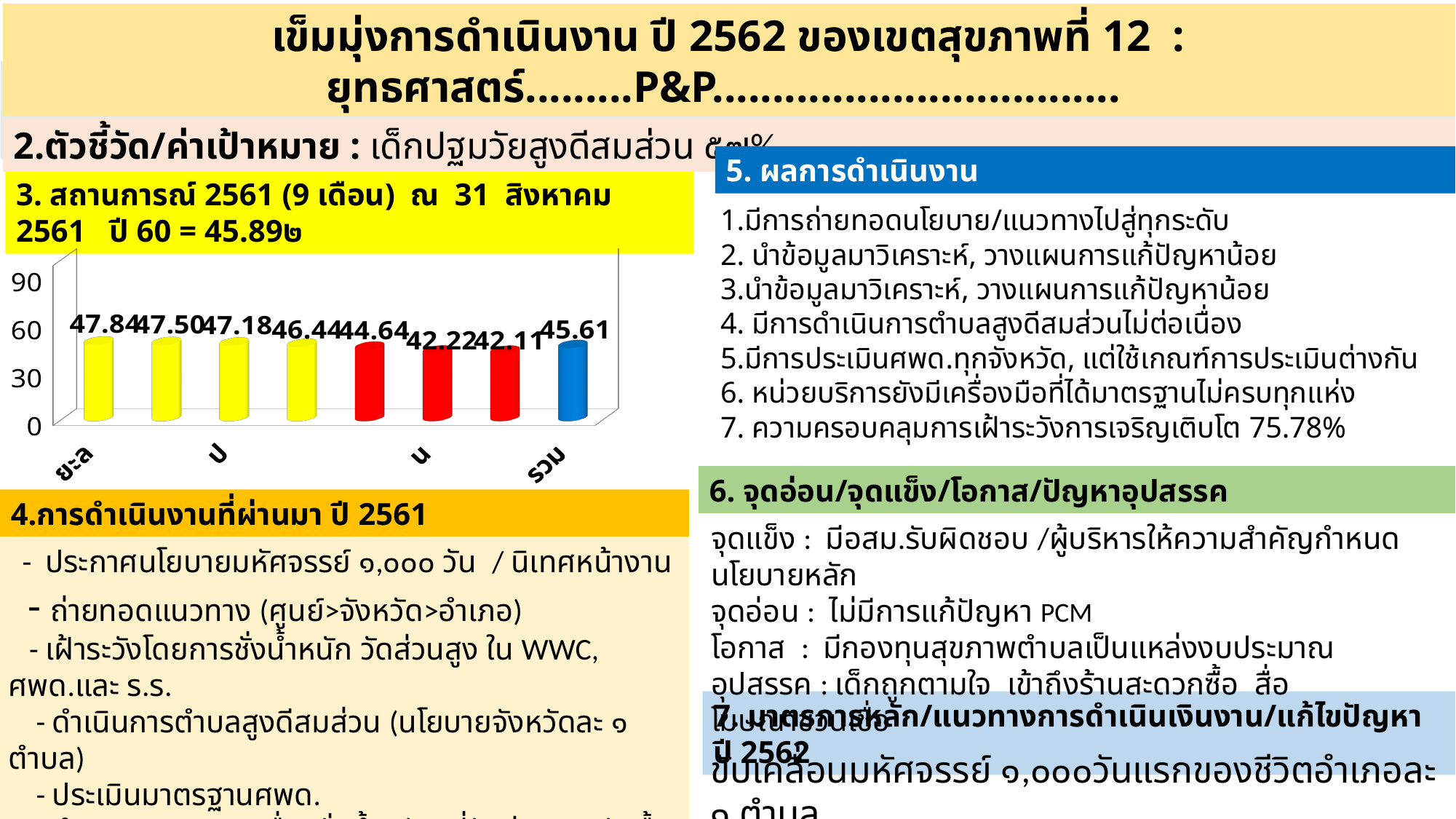
What is the difference between the values for ยะลา and รวม? 2.23 Is the value for รวม greater or less than 60? less How many bars are plotted in the chart? 8 What is the value shown for รวม in the chart? 45.61 Which is larger, the value for ยะลา or the value for รวม? ยะลา Do the values of the first seven bars rise or fall from left to right? fall What is the lowest value labelled on any bar in the chart? 42.11 What is the value shown for ยะลา in the chart? 47.84 How many bars in the chart are yellow? 4 What colour is the bar for รวม? blue Which category has the highest value in the chart? ยะลา What kind of chart is shown on the slide? bar chart